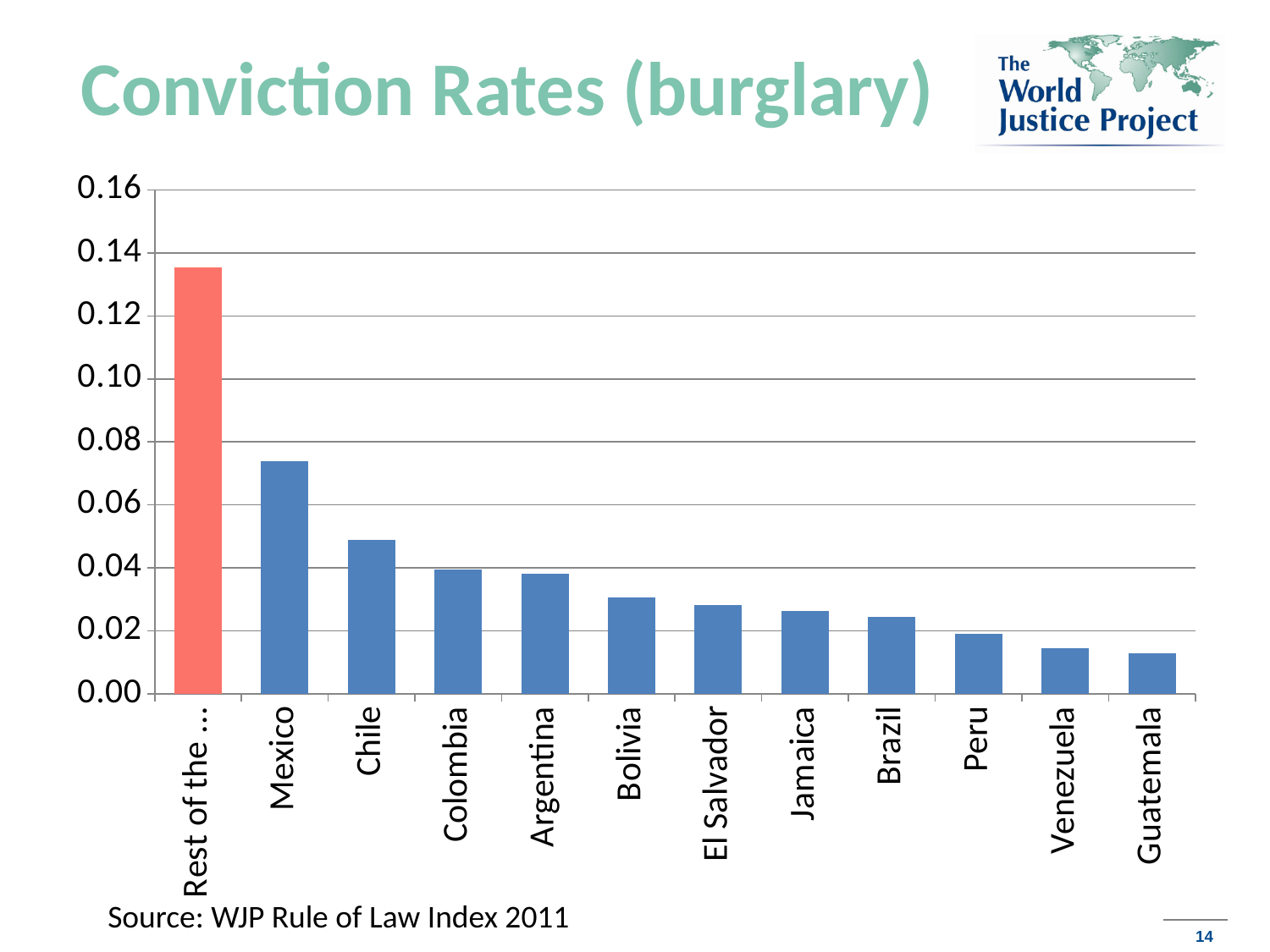
Is the value for Venezuela greater or less than 0.02? less Is the value for Bolivia greater or less than 0.04? less Which has a higher conviction rate, Mexico or Chile? Mexico What is the title of the chart? Conviction Rates (burglary) Is the value for Chile greater or less than 0.06? less Do the values rise or fall moving from left to right along the x axis? fall How many categories are plotted on the x axis? 12 Which country has the lowest conviction rate in the chart? Guatemala Which category has the highest bar in the chart? Rest of the … What kind of chart is shown on the slide? bar chart Which has a higher conviction rate, Bolivia or Brazil? Bolivia